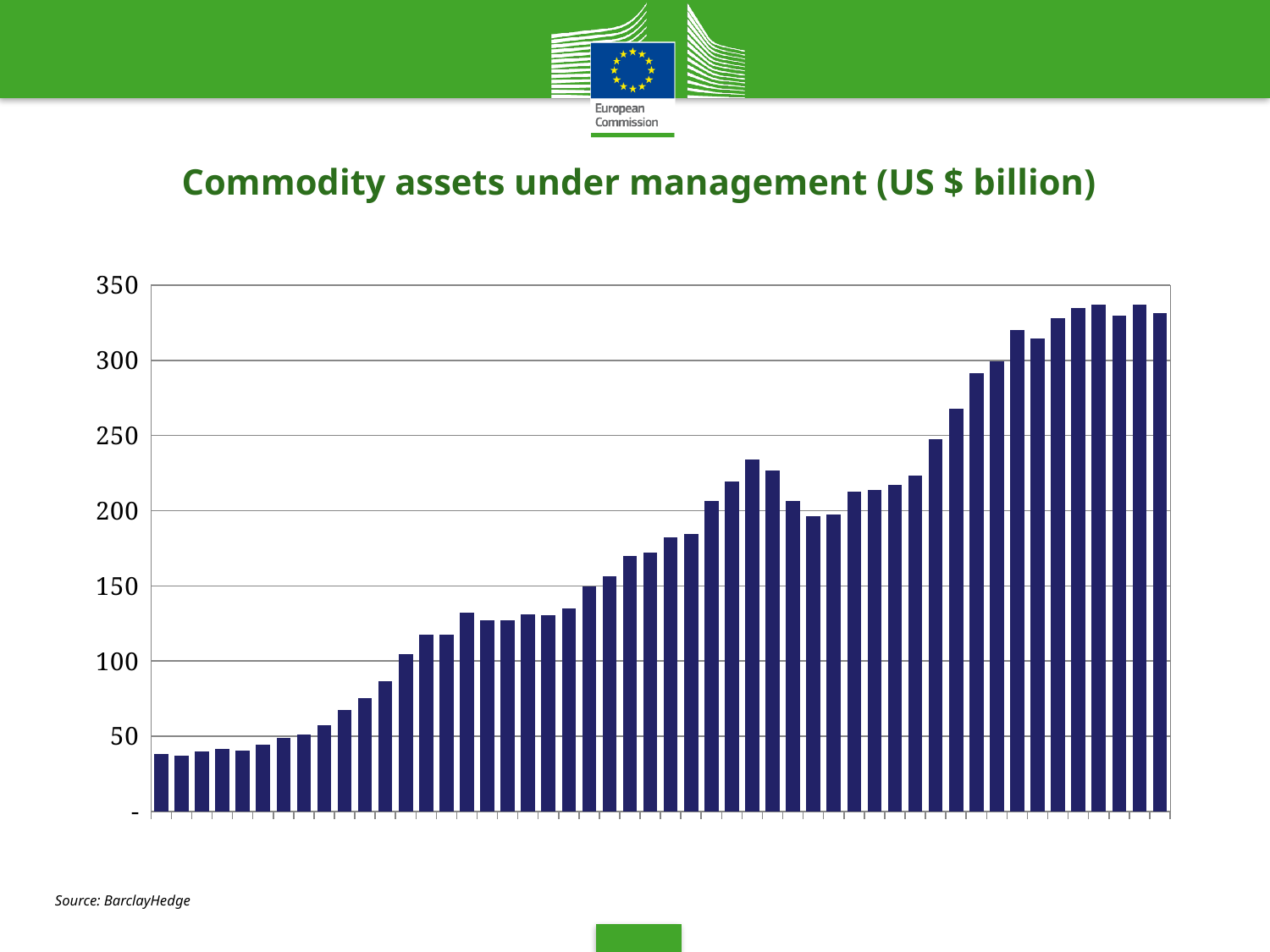
What is the title of the chart? Commodity assets under management (US $ billion) Is the value of the first (leftmost) bar greater or less than 50? less What is the highest value shown on the y axis? 350 Is the value of the shortest bar greater or less than 50? less What kind of chart is shown on the slide? bar chart Is the value of the last (rightmost) bar greater or less than 300? greater Which is larger, the value of the first bar or the value of the last bar? the last bar What source is cited for the chart? BarclayHedge Do the values generally rise or fall from left to right along the x axis? rise